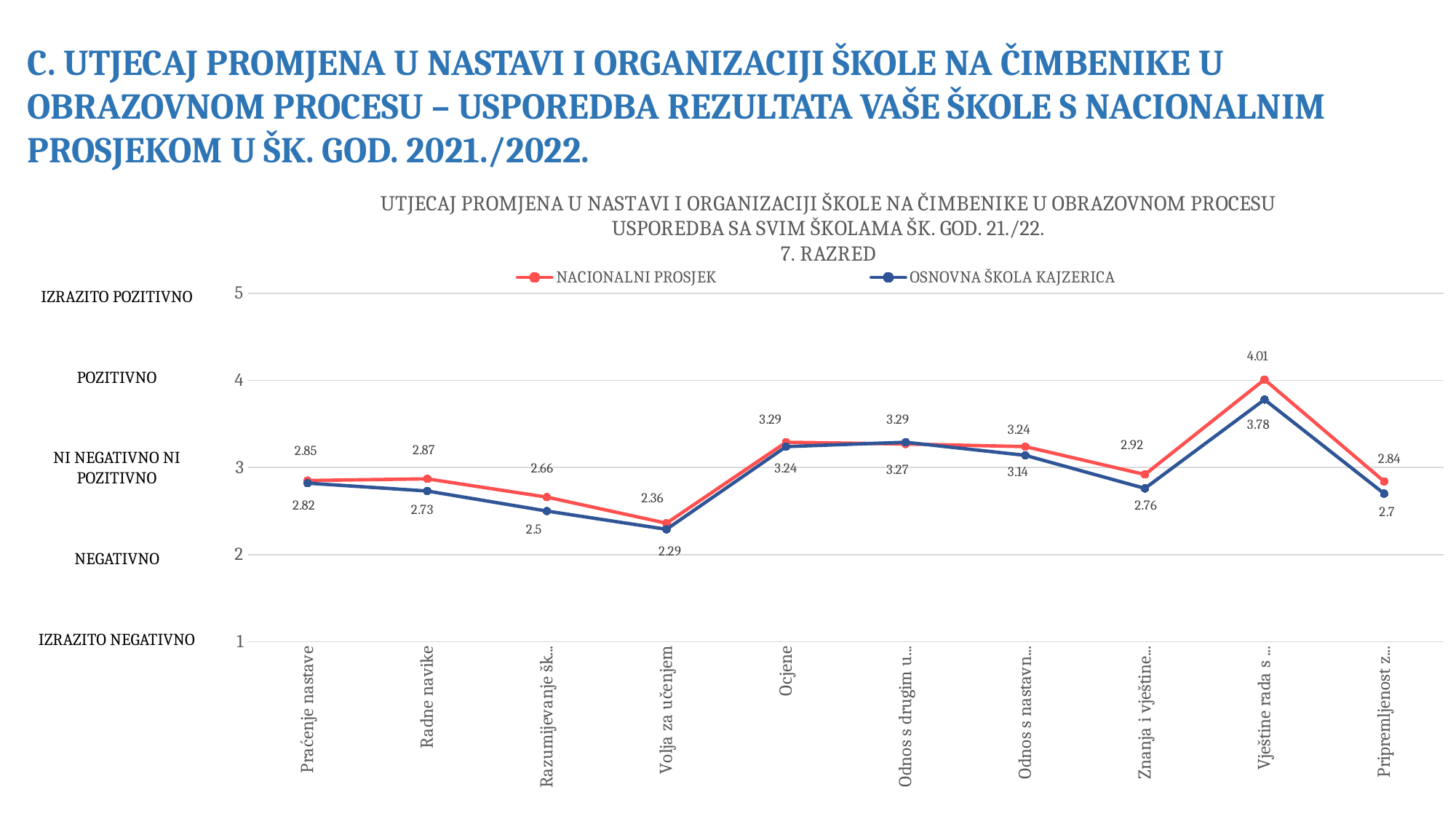
What is the OSNOVNA ŠKOLA KAJZERICA value for Radne navike? 2.73 How many categories are plotted along the x axis? 10 For Ocjene, which series has the larger value, NACIONALNI PROSJEK or OSNOVNA ŠKOLA KAJZERICA? NACIONALNI PROSJEK Which series is drawn in red? NACIONALNI PROSJEK What kind of chart is shown on the slide? line chart What is the OSNOVNA ŠKOLA KAJZERICA value for Praćenje nastave? 2.82 Which category has the lowest OSNOVNA ŠKOLA KAJZERICA value? Volja za učenjem What is the NACIONALNI PROSJEK value for Volja za učenjem? 2.36 Which category has the lowest NACIONALNI PROSJEK value? Volja za učenjem How many series does the legend list? 2 What is the NACIONALNI PROSJEK value for Ocjene? 3.29 What is the difference between the NACIONALNI PROSJEK and OSNOVNA ŠKOLA KAJZERICA values for Radne navike? 0.14